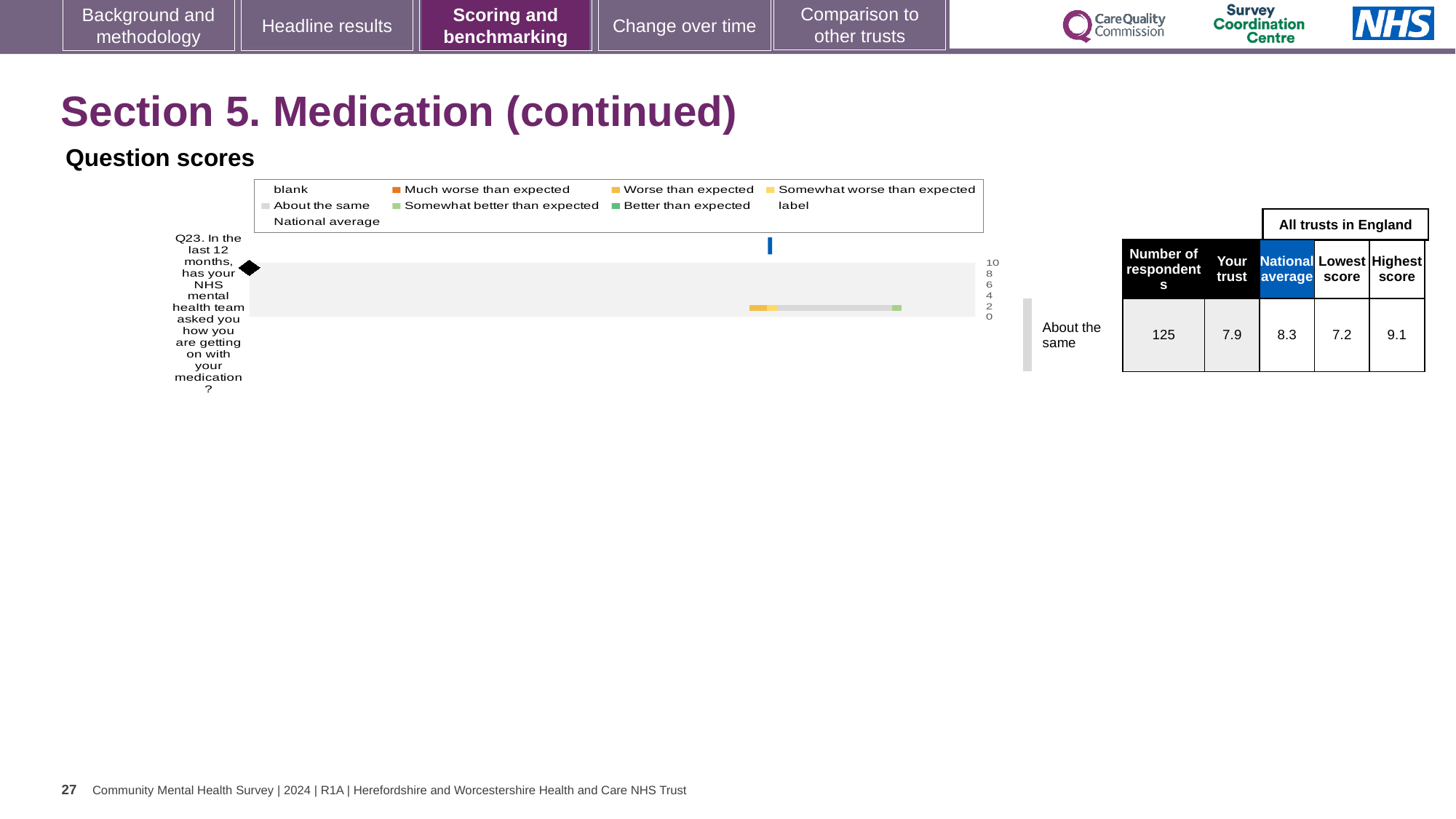
What is the difference between the highest and lowest scores among all trusts in England for Q23? 1.9 How many survey questions are plotted in the Question scores chart? 1 What is the national average score for Q23? 8.3 What is the difference between the national average and the trust's score for Q23? 0.4 How many respondents answered Q23? 125 What is the highest score among all trusts in England for Q23? 9.1 What is the lowest score among all trusts in England for Q23? 7.2 Is the trust's score for Q23 greater or less than 6 on the chart's axis? greater What is the "Your trust" score for Q23 about being asked how you are getting on with your medication? 7.9 Which benchmark category is the trust's Q23 score placed in? About the same Which is larger for Q23, the trust's score or the national average? national average What kind of chart is shown under "Question scores"? bar chart